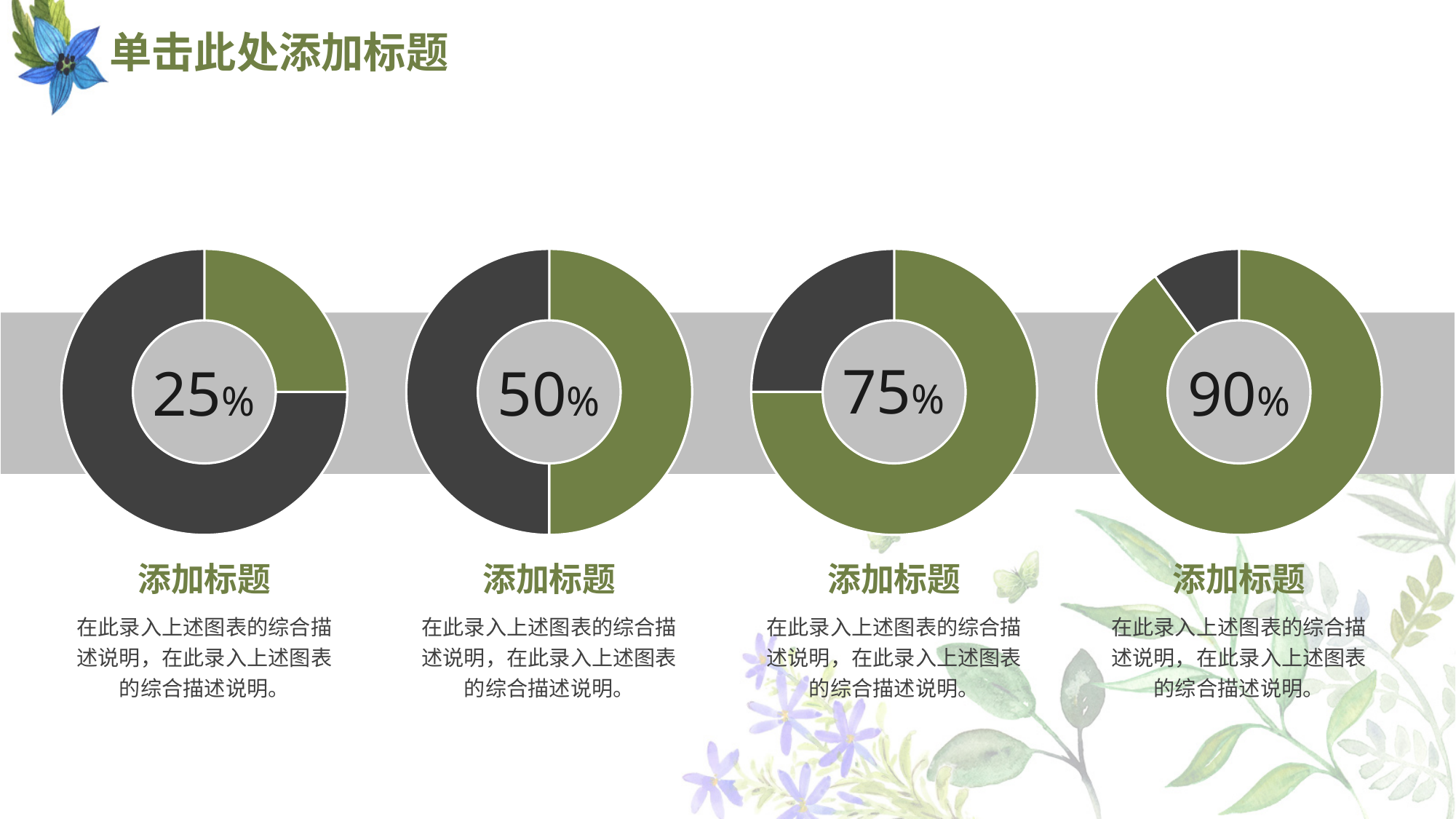
Which donut chart shows the highest percentage? The rightmost chart (90%) What kind of chart is used on this slide? Donut chart Which donut chart shows the lowest percentage? The leftmost chart (25%) Which shows a larger percentage, the second donut chart from the left or the third donut chart from the left? The third donut chart (75%) What percentage is shown in the centre of the rightmost donut chart? 90% What percentage is shown in the centre of the leftmost donut chart? 25% Do the percentages in the donut charts increase or decrease from left to right across the slide? Increase What is the difference between the percentage in the rightmost donut chart and the percentage in the leftmost donut chart? 65% How many donut charts are on the slide? 4 What percentage is shown in the centre of the third donut chart from the left? 75% What is the difference between the percentages shown in the third and second donut charts from the left? 25% What percentage is shown in the centre of the second donut chart from the left? 50%